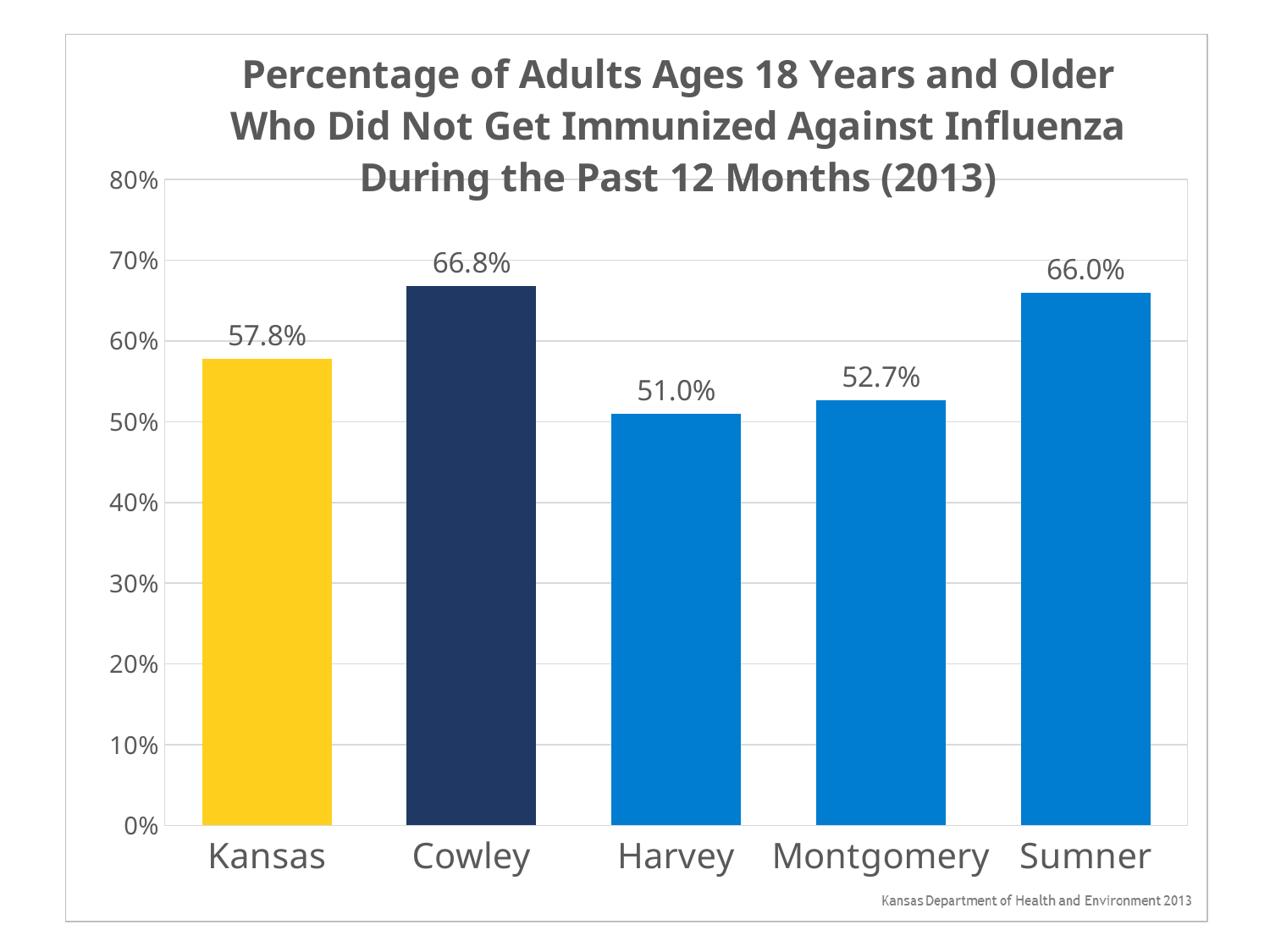
What is the value shown for Harvey? 51.0% What is the value shown for Montgomery? 52.7% Which is larger, the value for Montgomery or the value for Kansas? Kansas What is the difference between the values for Cowley and Harvey? 15.8% How many categories are shown on the chart? 5 What is the difference between the values for Sumner and Kansas? 8.2% What percentage of adults in Cowley did not get immunized against influenza? 66.8% Which county has the highest percentage of adults who did not get immunized? Cowley Is the value for Sumner greater or less than 60%? greater What kind of chart is shown on the slide? Bar chart Which category has the lowest value on the chart? Harvey What is the value shown for Kansas? 57.8%